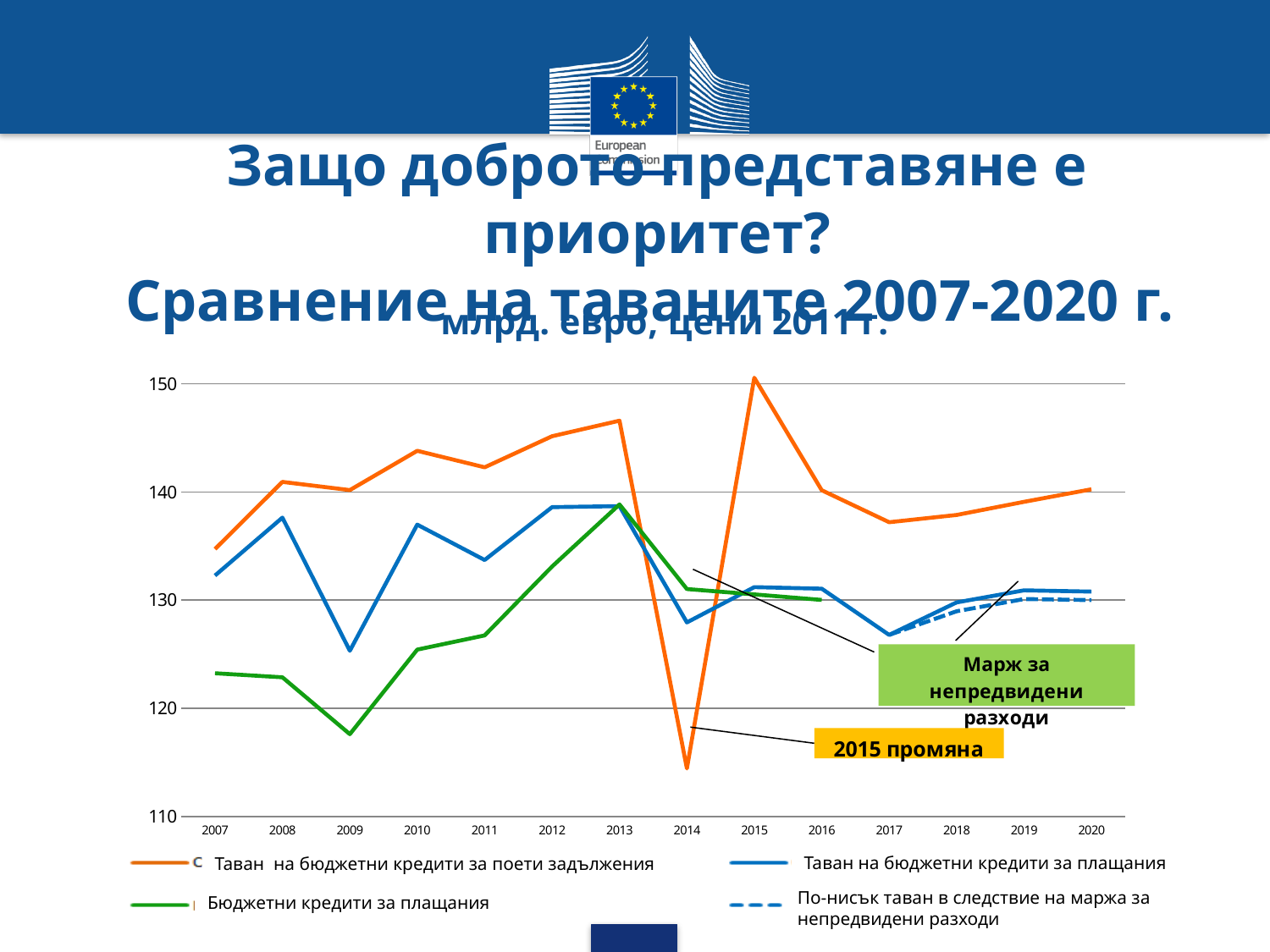
In which year does the series 'Бюджетни кредити за плащания' reach its lowest value? 2009 In which year does the series 'Таван на бюджетни кредити за поети задължения' reach its highest value? 2015 How many series does the chart's legend list? 4 Is the value for 'Бюджетни кредити за плащания' in 2013 greater or less than 130? greater In 2014, which is larger: 'Таван на бюджетни кредити за поети задължения' or 'Таван на бюджетни кредити за плащания'? Таван на бюджетни кредити за плащания Is the value for 'Таван на бюджетни кредити за плащания' in 2009 greater or less than 130? less Is the value for 'Таван на бюджетни кредити за поети задължения' in 2014 greater or less than 120? less How many years are plotted along the x axis of the chart? 14 What does the yellow annotation box on the chart say? 2015 промяна Does the series 'Таван на бюджетни кредити за поети задължения' rise or fall from 2017 to 2020? rise What kind of chart is shown on the slide? line chart In which year does the series 'Таван на бюджетни кредити за поети задължения' reach its lowest value? 2014